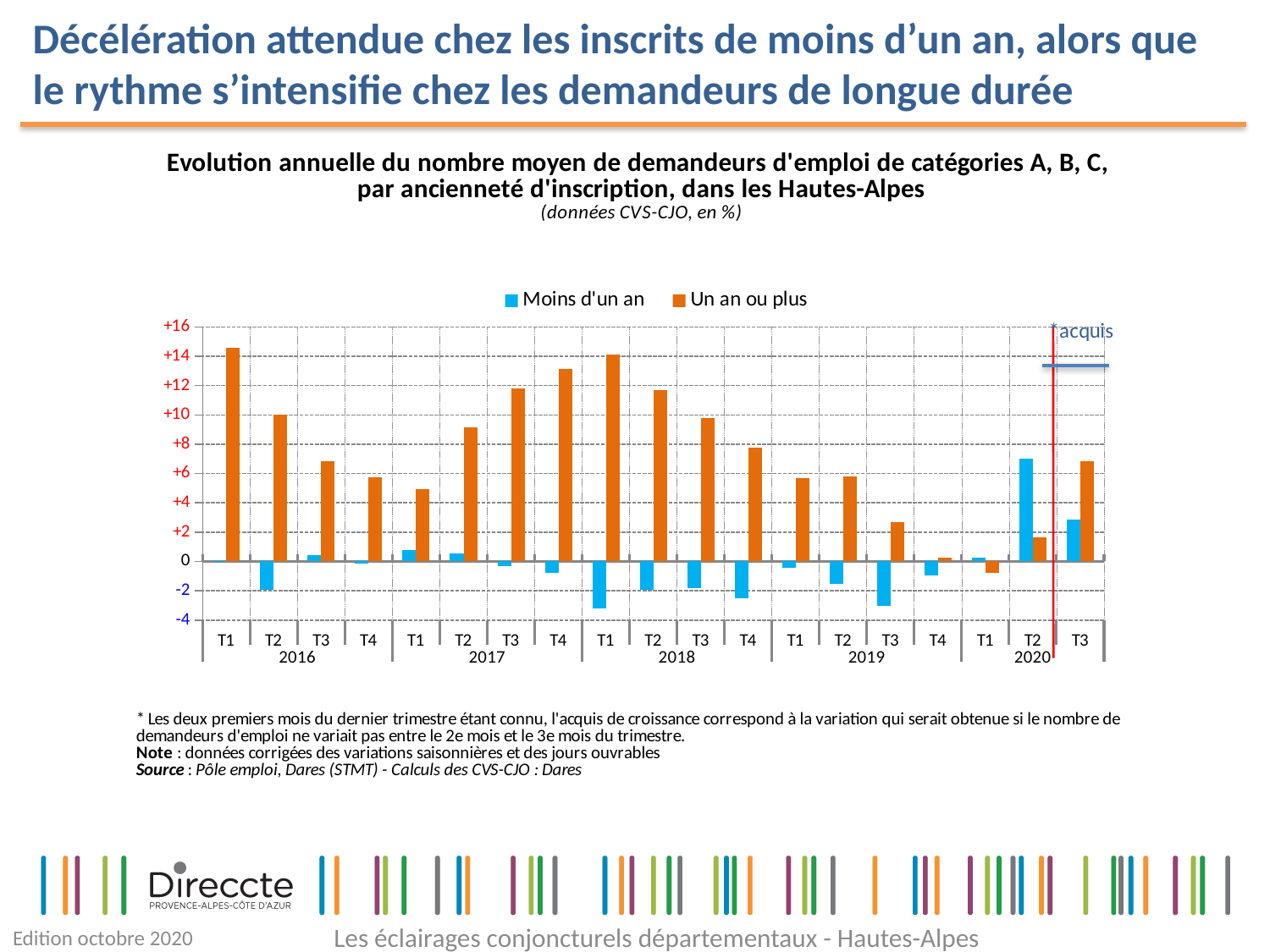
In which quarter is the value for 'Moins d'un an' the highest? T2 2020 How many series does the legend list? 2 Is the value for 'Un an ou plus' in T3 2017 greater or less than +10? greater In T2 2020, which series has the larger value, 'Moins d'un an' or 'Un an ou plus'? Moins d'un an Is the value for 'Moins d'un an' in T2 2020 greater or less than +6? greater In which quarter is the value for 'Un an ou plus' the lowest? T1 2020 Is the value for 'Moins d'un an' in T1 2018 greater or less than -2? less Which series is shown in orange? Un an ou plus What kind of chart is shown on the slide? bar chart Does the value for 'Un an ou plus' rise or fall from T1 2016 to T1 2017? fall How many quarters are plotted along the x axis? 19